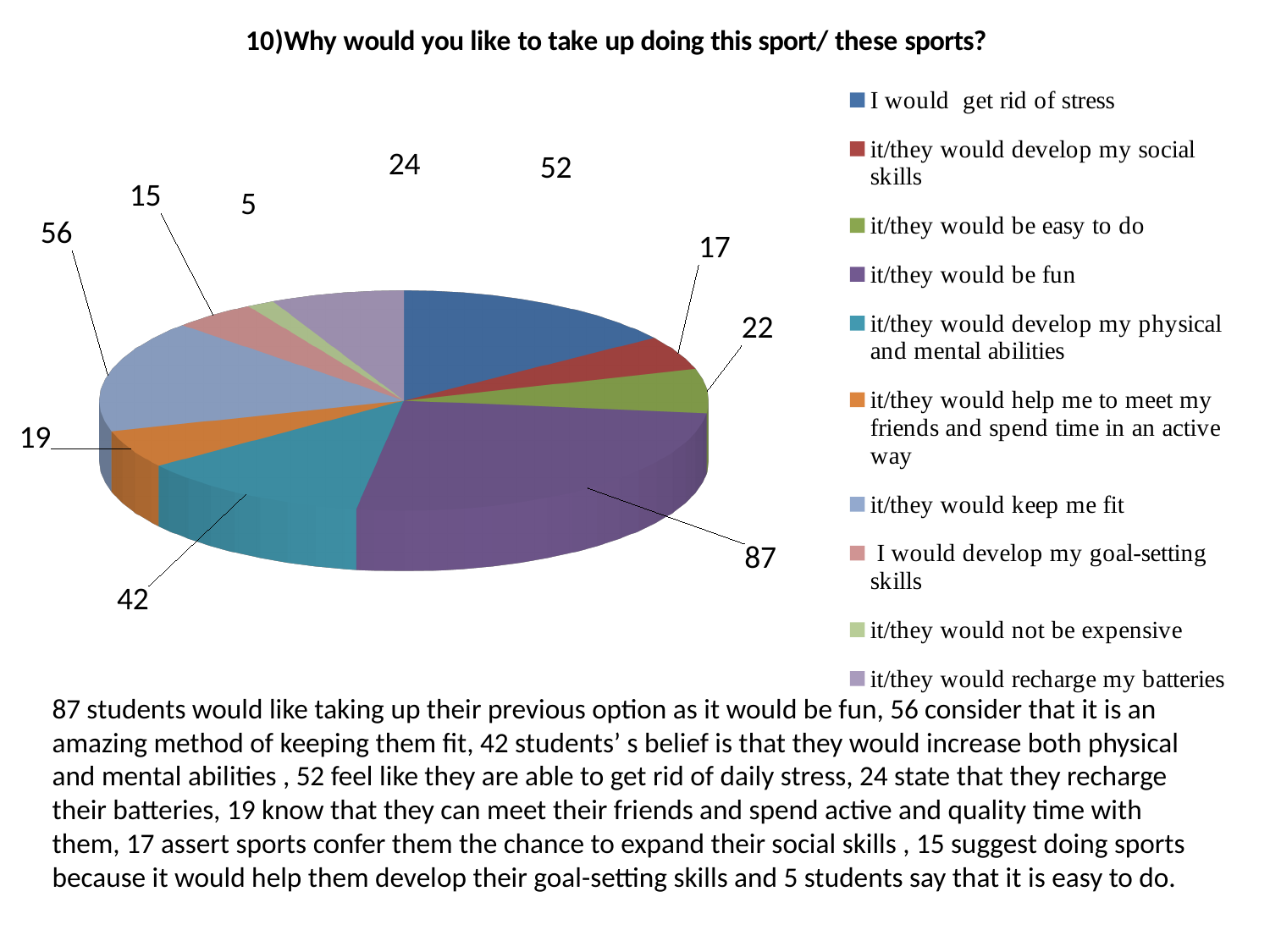
What is the difference between the values for 'it/they would be fun' and 'it/they would keep me fit'? 31 What is the value for 'it/they would help me to meet my friends and spend time in an active way'? 19 How many categories does the pie chart have? 10 How many students said it/they would be fun? 87 Which is larger: the value for 'I would get rid of stress' or for 'it/they would develop my physical and mental abilities'? I would get rid of stress What is the title of the slide above the chart? 10)Why would you like to take up doing this sport/ these sports? What is the value for 'I would develop my goal-setting skills'? 15 What is the value for 'I would get rid of stress'? 52 What is the value for 'it/they would keep me fit'? 56 What kind of chart is shown on the slide? pie chart Which reason has the largest slice of the pie? it/they would be fun What is the value for 'it/they would develop my physical and mental abilities'? 42